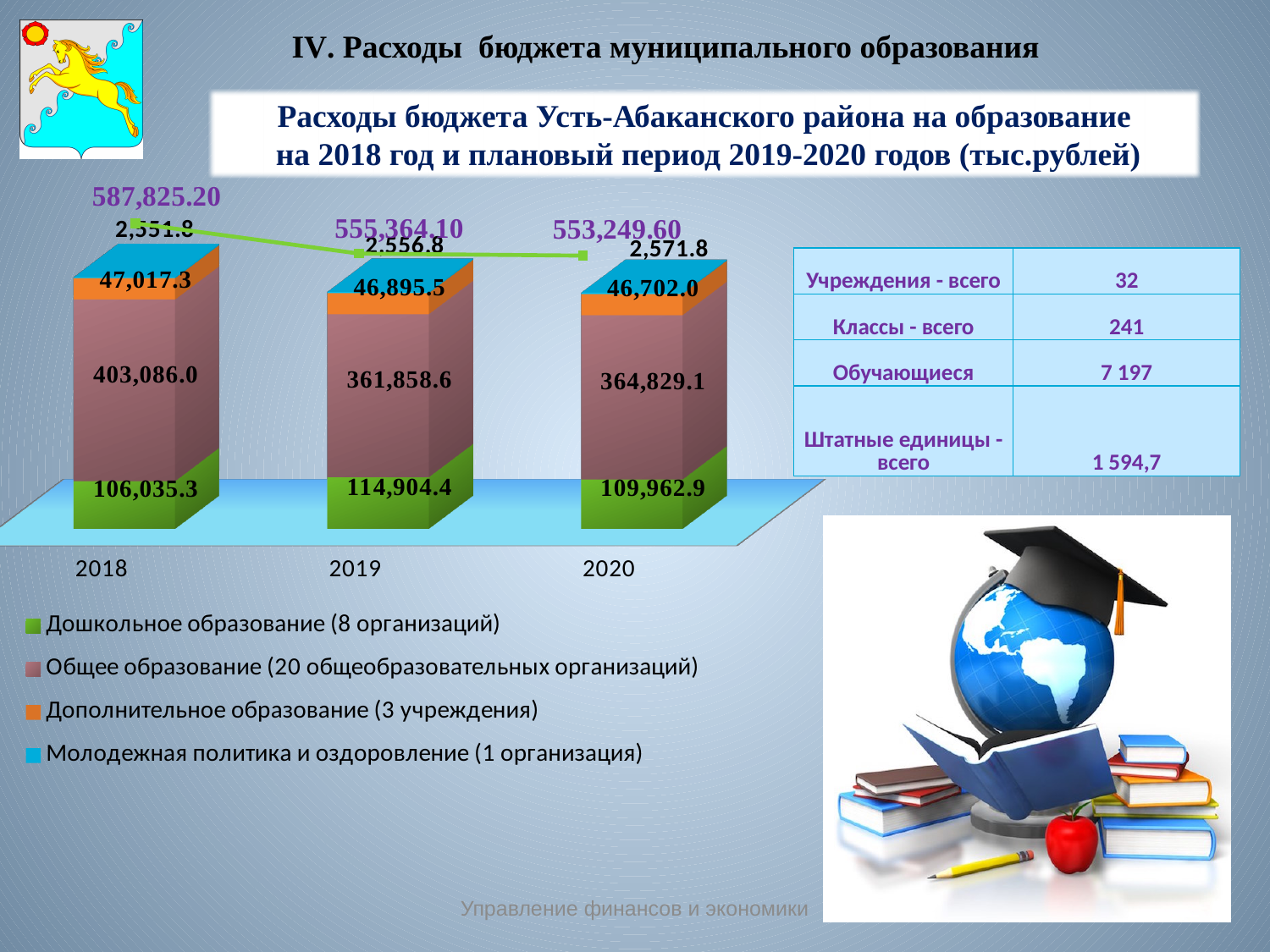
What is the difference between the total expenditure in 2018 and in 2019? 32,461.10 What is the value for Дополнительное образование in 2020? 46,702.0 Which year has the lowest value for Дошкольное образование? 2018 What is the total expenditure shown for 2019? 555,364.10 What is the value for Общее образование in 2018? 403,086.0 How many series does the legend list? 4 Which year has the highest total expenditure on education? 2018 What is the difference between the Дошкольное образование values for 2019 and 2018? 8,869.1 Do the total expenditures rise or fall from 2018 to 2020? fall What is the value for Молодежная политика и оздоровление in 2020? 2,571.8 Which is larger: Общее образование in 2019 or in 2020? 2020 What is the value for Дошкольное образование in 2019? 114,904.4